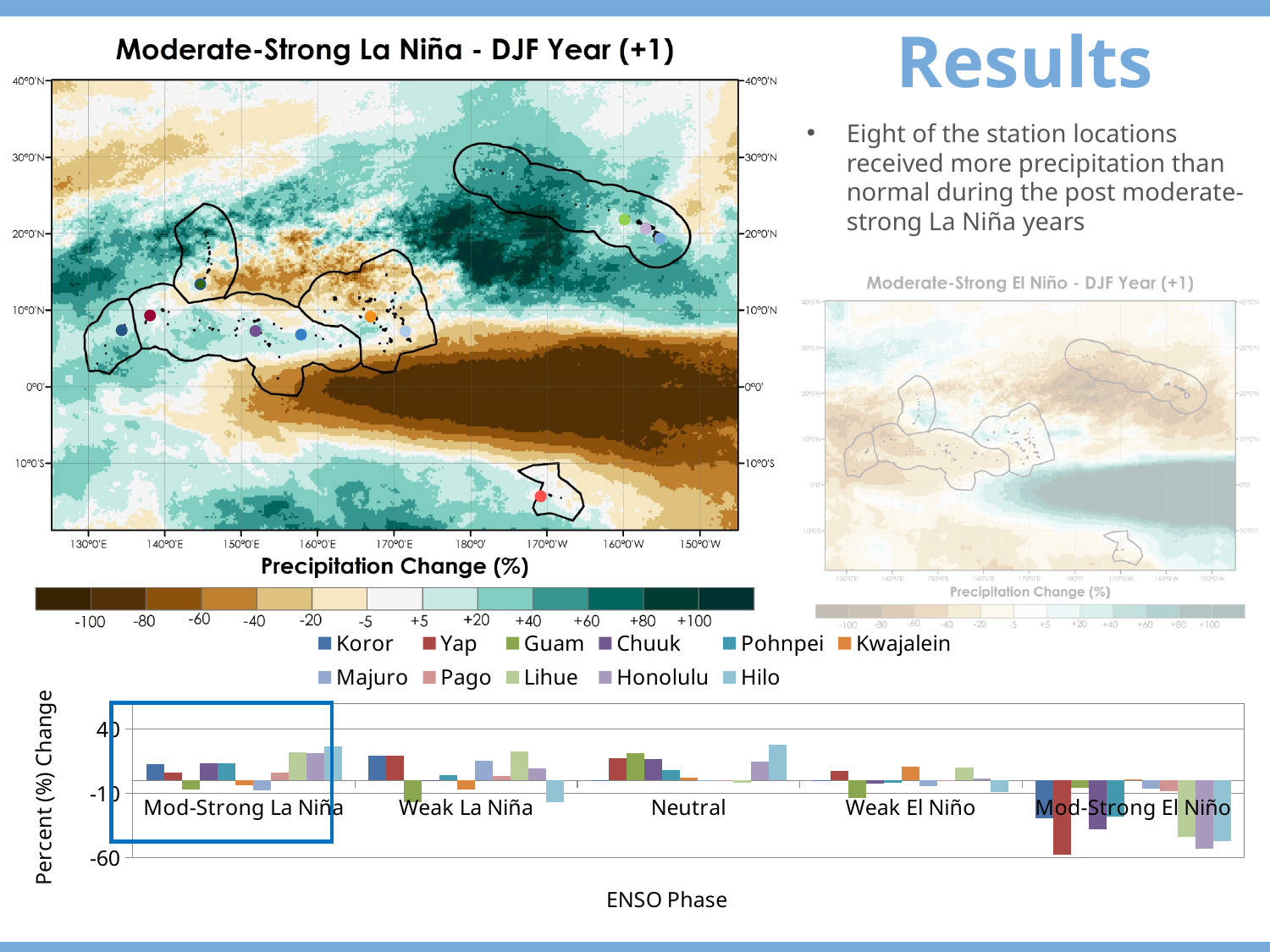
In the bottom bar chart, how many ENSO phase categories are shown on the x axis? 5 In the bottom bar chart, is the value for Yap in the Mod-Strong El Niño phase greater or less than -10? less In the bottom bar chart, is the value for Honolulu in the Mod-Strong El Niño phase greater or less than -10? less In the bottom bar chart, which is larger in the Mod-Strong La Niña phase, the value for Hilo or the value for Guam? Hilo In the bottom bar chart, which is larger in the Mod-Strong El Niño phase, the value for Koror or the value for Yap? Koror In the bottom bar chart, what is the label of the x axis? ENSO Phase What kind of chart is the chart at the bottom of the slide with ENSO Phase on the x axis? bar chart In the bottom bar chart, what is the label of the y axis? Percent (%) Change In the bottom bar chart, is the value for Hilo in the Mod-Strong La Niña phase greater or less than -10? greater In the bottom bar chart, how many series does the legend list? 11 In the bottom bar chart, which ENSO phase category is highlighted with a blue rectangle? Mod-Strong La Niña